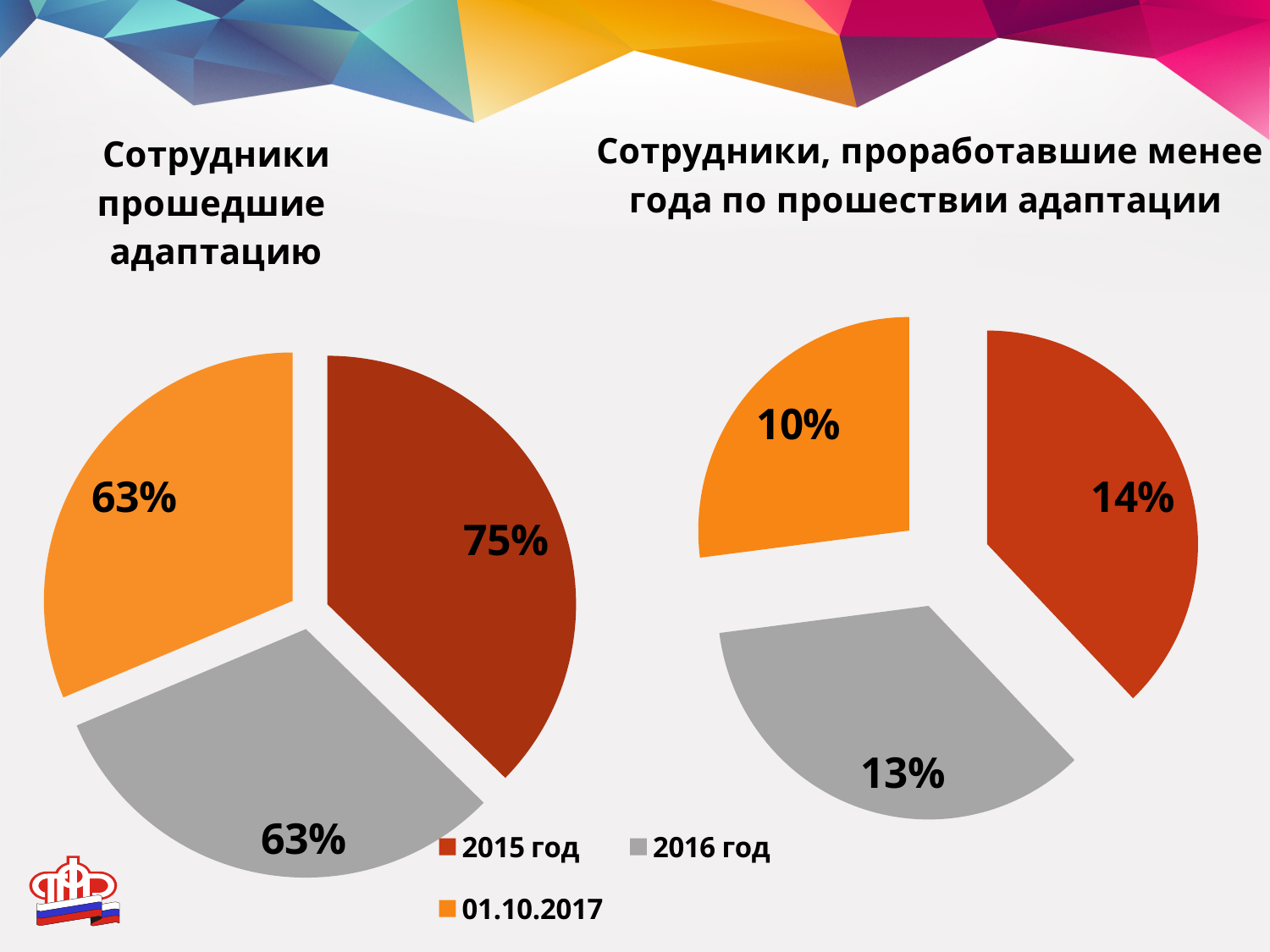
On the chart titled «Сотрудники, проработавшие менее года по прошествии адаптации», which period has the lowest value? 01.10.2017 On the chart titled «Сотрудники прошедшие адаптацию», what is the difference between the values for 2015 год and 2016 год? 12% What kind of chart is used on the left side of the slide? Pie chart How many entries does the legend list? 3 On the chart titled «Сотрудники, проработавшие менее года по прошествии адаптации», which is larger: the value for 2015 год or for 2016 год? 2015 год On the chart titled «Сотрудники, проработавшие менее года по прошествии адаптации», what value is shown for 2016 год? 13% On the chart titled «Сотрудники, проработавшие менее года по прошествии адаптации», which period has the highest value? 2015 год On the chart titled «Сотрудники, проработавшие менее года по прошествии адаптации», what is the difference between the values for 2015 год and 01.10.2017? 4% On the chart titled «Сотрудники прошедшие адаптацию», what value is shown for 2015 год? 75% On the chart titled «Сотрудники прошедшие адаптацию», what value is shown for 2016 год? 63% On the chart titled «Сотрудники прошедшие адаптацию», which period has the highest value? 2015 год On the chart titled «Сотрудники, проработавшие менее года по прошествии адаптации», what value is shown for 01.10.2017? 10%